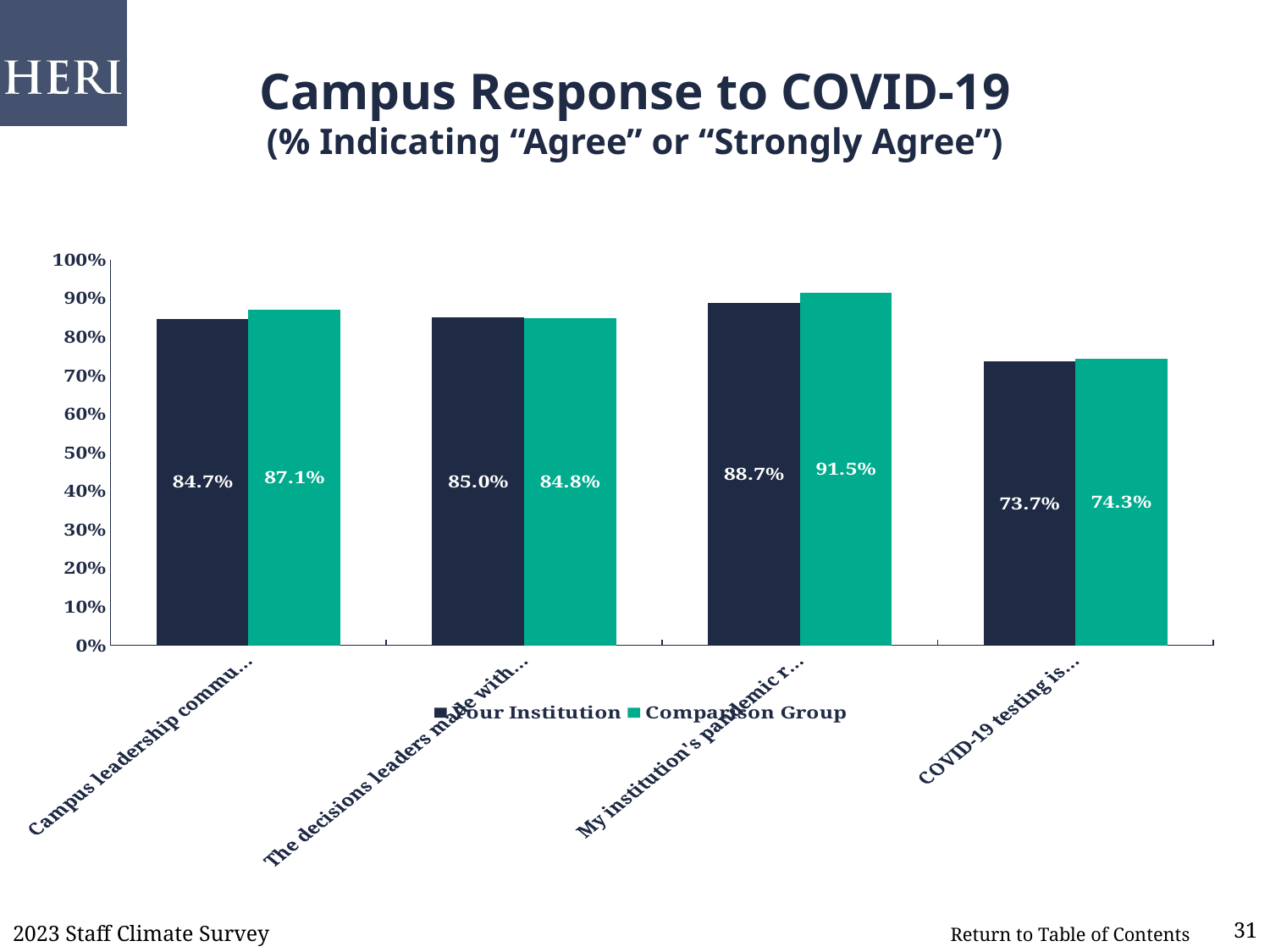
For the category labelled "The decisions leaders made with...", which series has the larger value, Your Institution or Comparison Group? Your Institution How many categories are shown on the x axis of the chart? 4 What kind of chart is shown on the slide? bar chart For the category labelled "My institution's pandemic r...", what is the difference between the Comparison Group and Your Institution values? 2.8 percentage points Is the Your Institution value for the category labelled "COVID-19 testing is..." greater or less than 80%? less Which category has the lowest Comparison Group value? COVID-19 testing is... What are the two series named in the legend? Your Institution and Comparison Group How many series does the legend list? 2 Which category has the highest Your Institution value? My institution's pandemic r... What is the Your Institution value for the category labelled "COVID-19 testing is..."? 73.7% What is the Comparison Group value for the category labelled "My institution's pandemic r..."? 91.5% For the category labelled "Campus leadership commu...", how much higher is the Comparison Group value than the Your Institution value? 2.4 percentage points